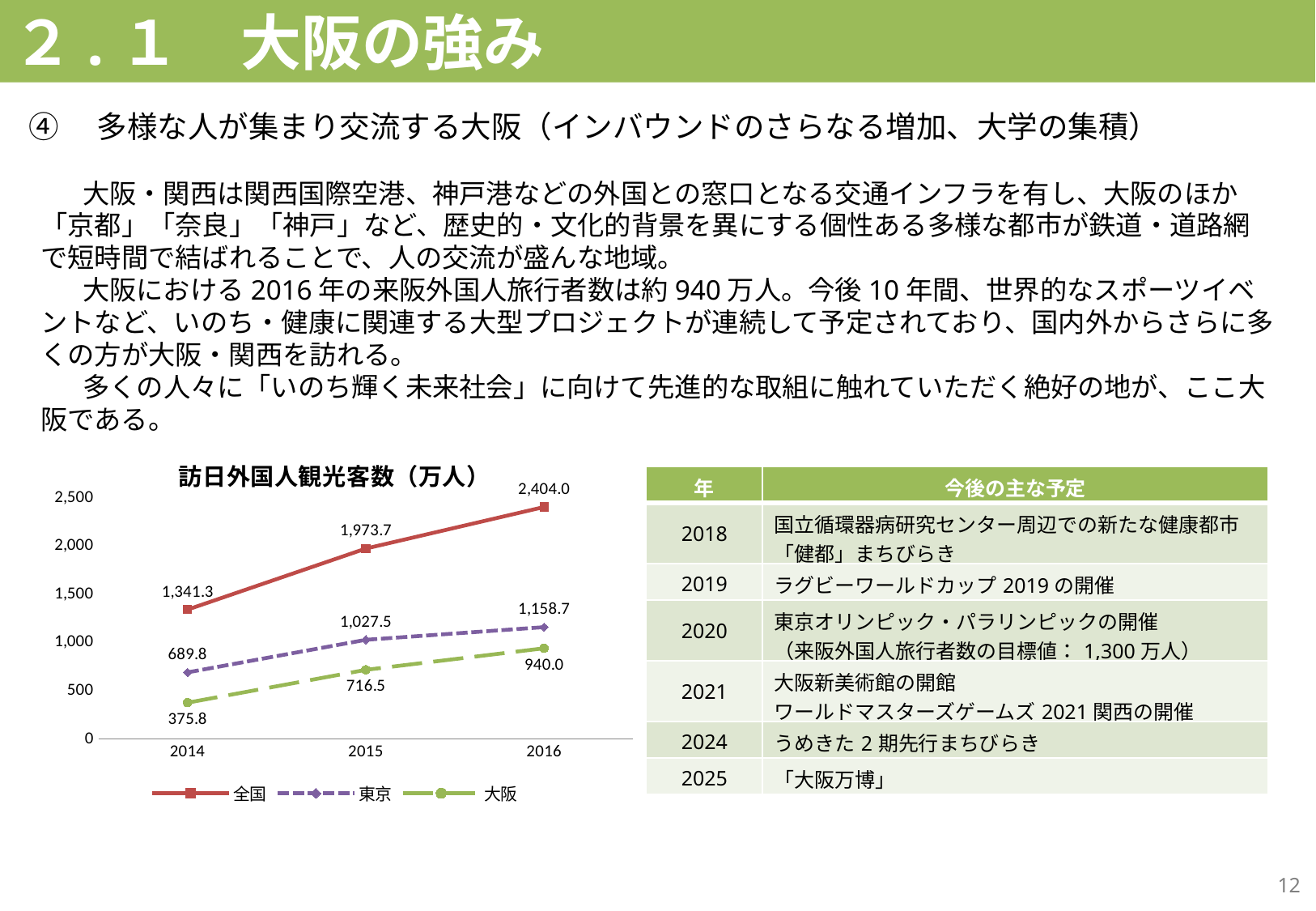
What is the value for 全国 in 2016 in the 訪日外国人観光客数（万人） chart? 2,404.0 In the 訪日外国人観光客数（万人） chart, which is larger in 2016: 東京 or 大阪? 東京 Which year has the highest value for 大阪 in the 訪日外国人観光客数（万人） chart? 2016 What is the difference between the 全国 values for 2016 and 2015 in the 訪日外国人観光客数（万人） chart? 430.3 What is the title of the line chart on the slide? 訪日外国人観光客数（万人） Do the 東京 values rise or fall from 2014 to 2016 in the 訪日外国人観光客数（万人） chart? rise How many years are shown on the x axis of the 訪日外国人観光客数（万人） chart? 3 What is the value for 東京 in 2015 in the 訪日外国人観光客数（万人） chart? 1,027.5 What is the value for 大阪 in 2014 in the 訪日外国人観光客数（万人） chart? 375.8 Which series has the lowest value in 2014 in the 訪日外国人観光客数（万人） chart? 大阪 What kind of chart is the 訪日外国人観光客数（万人） chart? line chart How many series does the legend of the 訪日外国人観光客数（万人） chart list? 3